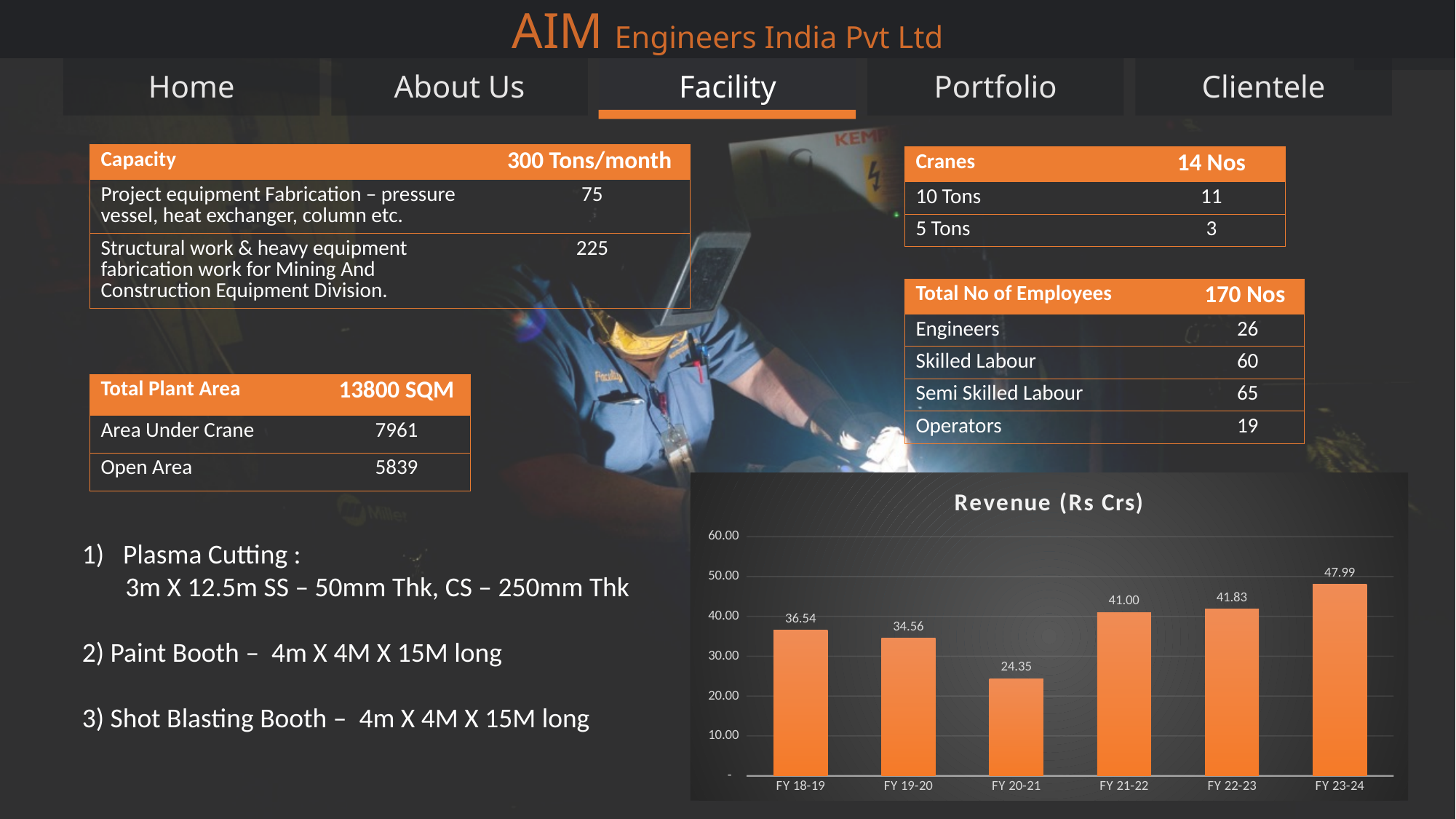
Which is larger, the revenue for FY 18-19 or FY 19-20? FY 18-19 Which fiscal year has the lowest revenue? FY 20-21 What kind of chart is used to show revenue? bar chart Does revenue rise or fall from FY 20-21 to FY 23-24? rise What is the title of the chart? Revenue (Rs Crs) Is the revenue for FY 21-22 greater or less than 40.00? greater Which fiscal year has the highest revenue? FY 23-24 What is the revenue for FY 20-21? 24.35 What is the difference in revenue between FY 23-24 and FY 22-23? 6.16 What is the revenue for FY 18-19? 36.54 What is the revenue for FY 23-24? 47.99 How many fiscal years are shown in the revenue chart? 6